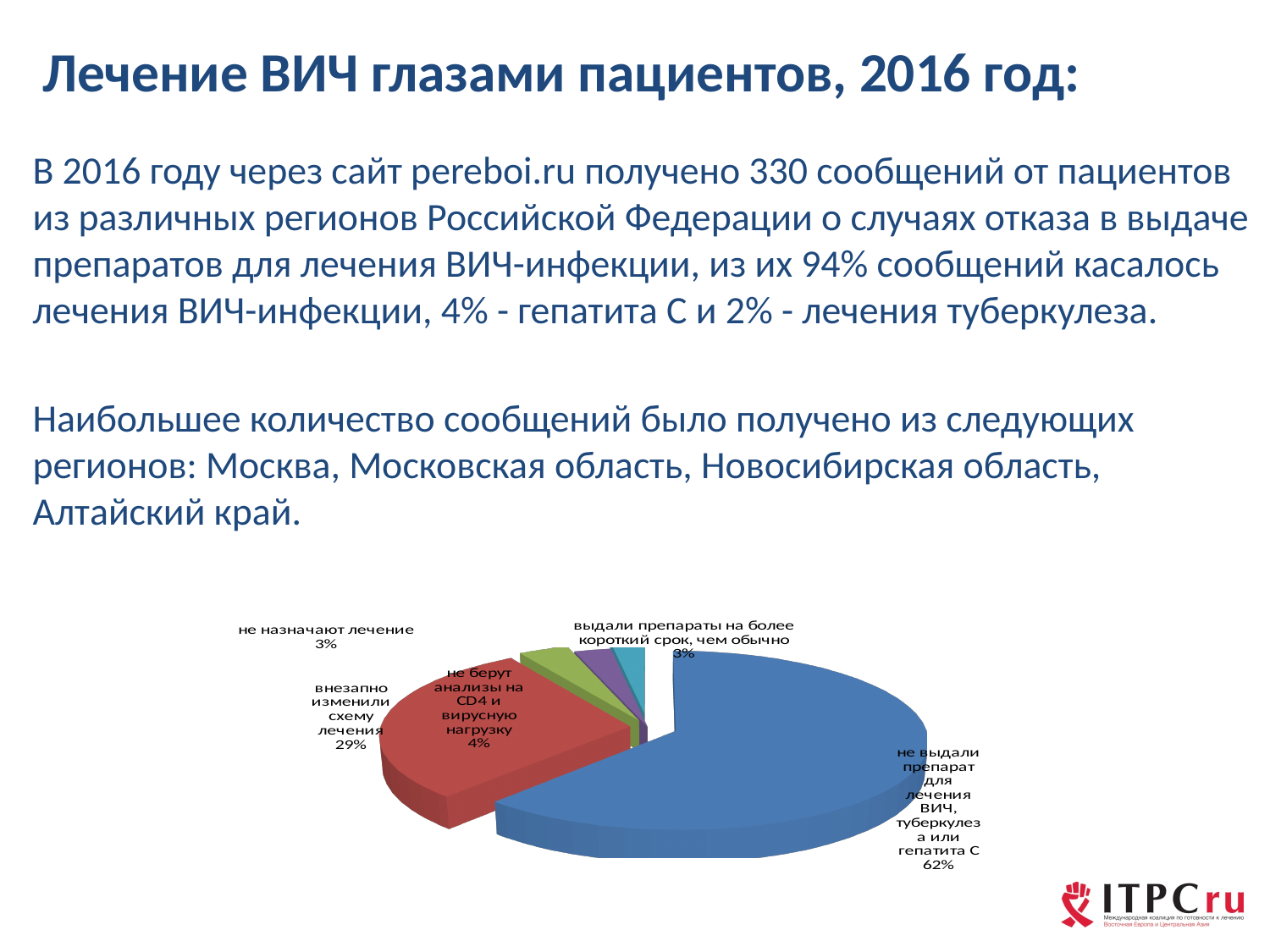
What share of the pie is labelled "не назначают лечение"? 3% What share of the pie is labelled "выдали препараты на более короткий срок, чем обычно"? 3% What share of the pie is labelled "не берут анализы на CD4 и вирусную нагрузку"? 4% What kind of chart is shown on the slide? pie chart What colour is the largest slice of the pie chart? blue Which category has the largest slice of the pie? не выдали препарат для лечения ВИЧ, туберкулеза или гепатита С What is the difference in percentage points between the "не выдали препарат для лечения ВИЧ, туберкулеза или гепатита С" slice and the "внезапно изменили схему лечения" slice? 33 percentage points Which slice is larger: "внезапно изменили схему лечения" or "не берут анализы на CD4 и вирусную нагрузку"? внезапно изменили схему лечения What is the difference in percentage points between the "не берут анализы на CD4 и вирусную нагрузку" slice and the "не назначают лечение" slice? 1 percentage point How many slices does the pie chart have? 5